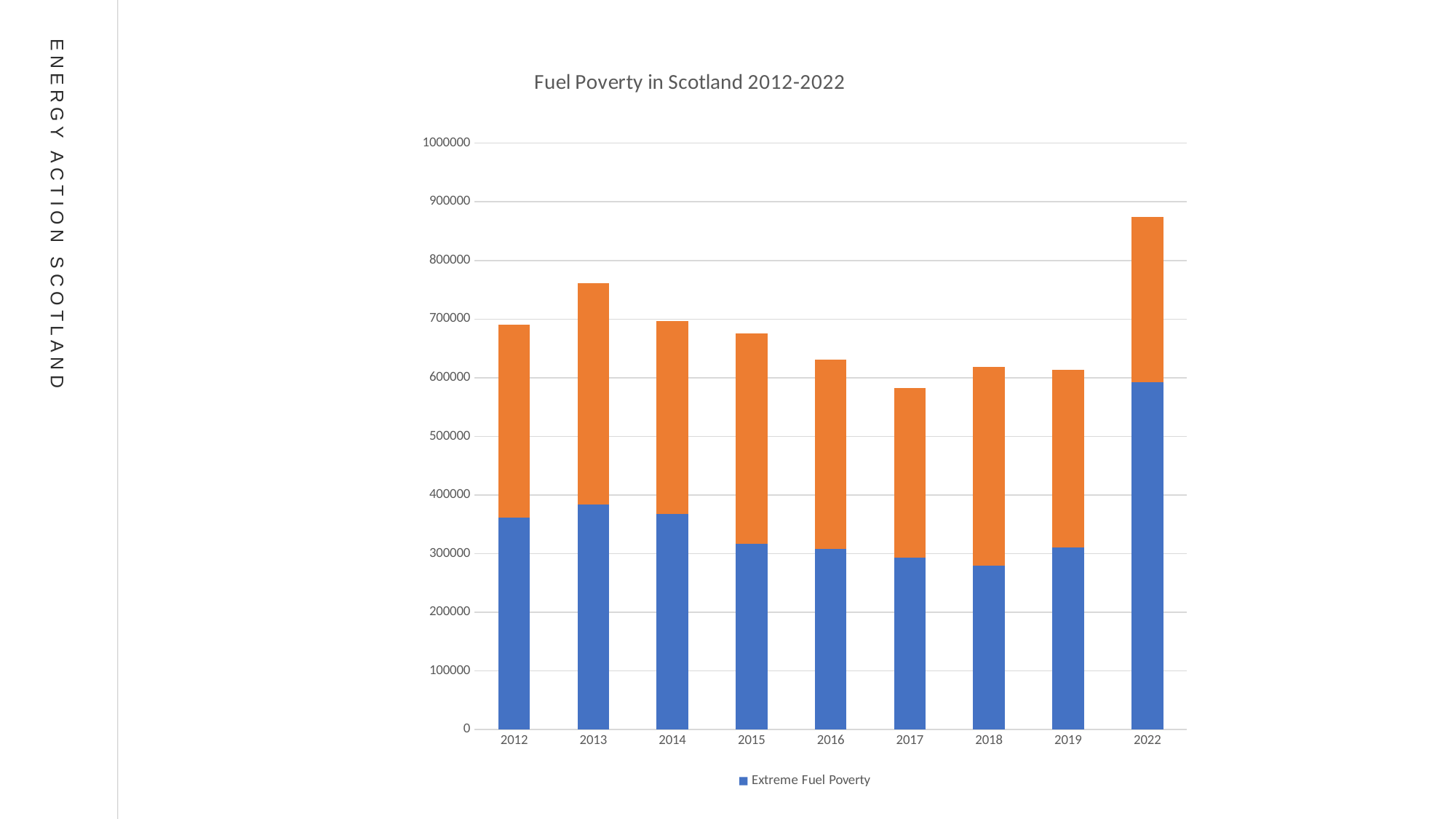
What is the title of the chart? Fuel Poverty in Scotland 2012-2022 Which year has the shortest stacked bar overall? 2017 What kind of chart is shown on the slide? Stacked bar chart How many years are shown on the x axis of the chart? 9 Is the total height of the bar for 2022 greater or less than 800000? greater Which year has the taller stacked bar overall, 2013 or 2014? 2013 Which series is named in the chart's legend? Extreme Fuel Poverty Is the Extreme Fuel Poverty value for 2012 greater or less than 400000? less Which year has the largest Extreme Fuel Poverty (blue) segment? 2022 Which year has the tallest stacked bar overall? 2022 Is the total height of the bar for 2017 greater or less than 600000? less How many series does the chart's legend list? 1